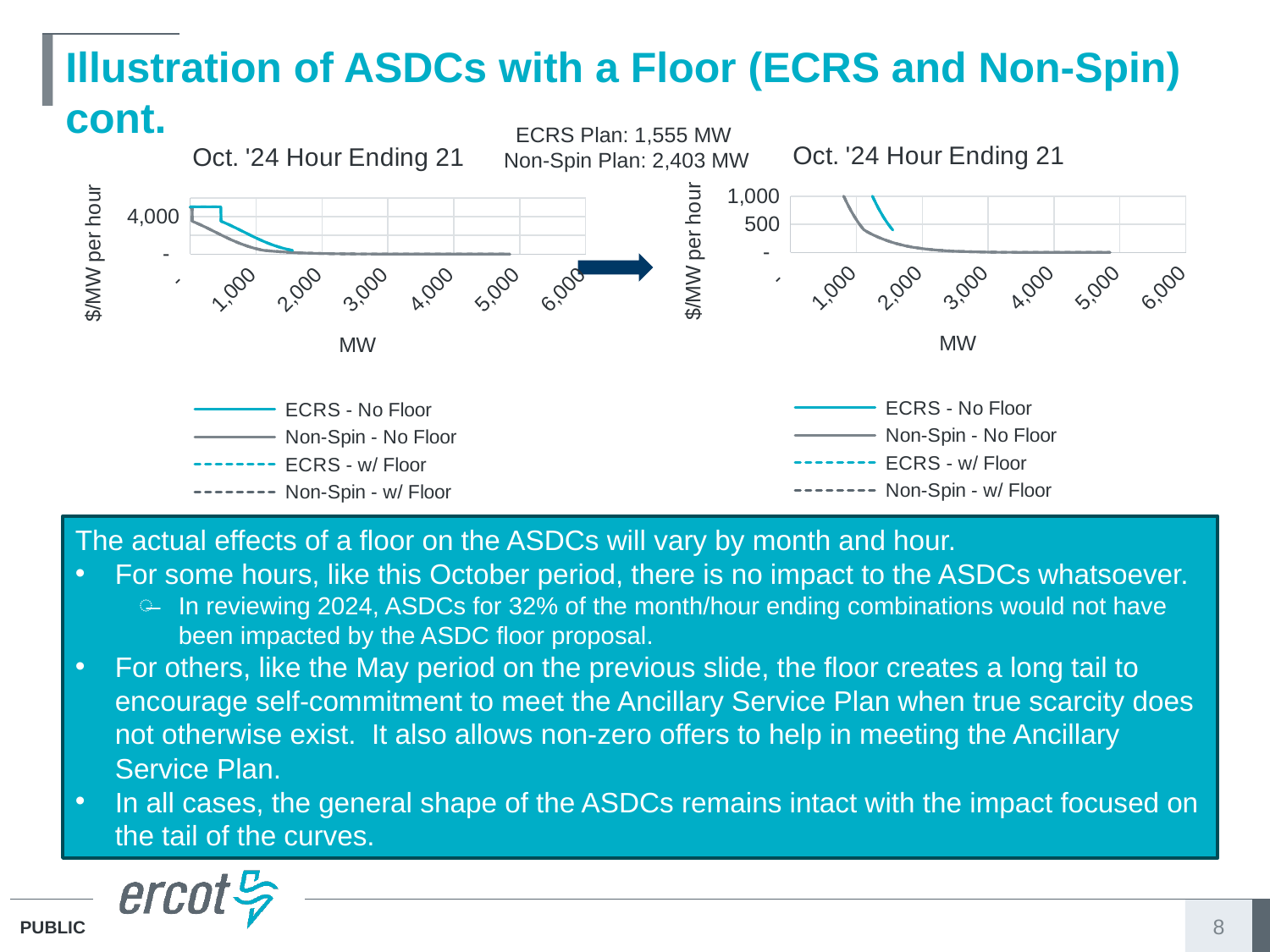
What is the y-axis label of the right chart? $/MW per hour What kind of chart is the left chart on the slide? line chart What kind of chart is the right chart on the slide? line chart How many series does the legend of the right chart list? 4 In the left chart, is the value of the Non-Spin - No Floor line at 3,000 MW greater or less than 4,000? less What is the title of the left chart? Oct. '24 Hour Ending 21 In the left chart, do the plotted values rise or fall as MW increases along the x axis? fall How many series does the legend of the left chart list? 4 In the right chart, do the plotted values rise or fall as MW increases along the x axis? fall In the right chart, is the value of the Non-Spin - No Floor line at 3,000 MW greater or less than 500? less